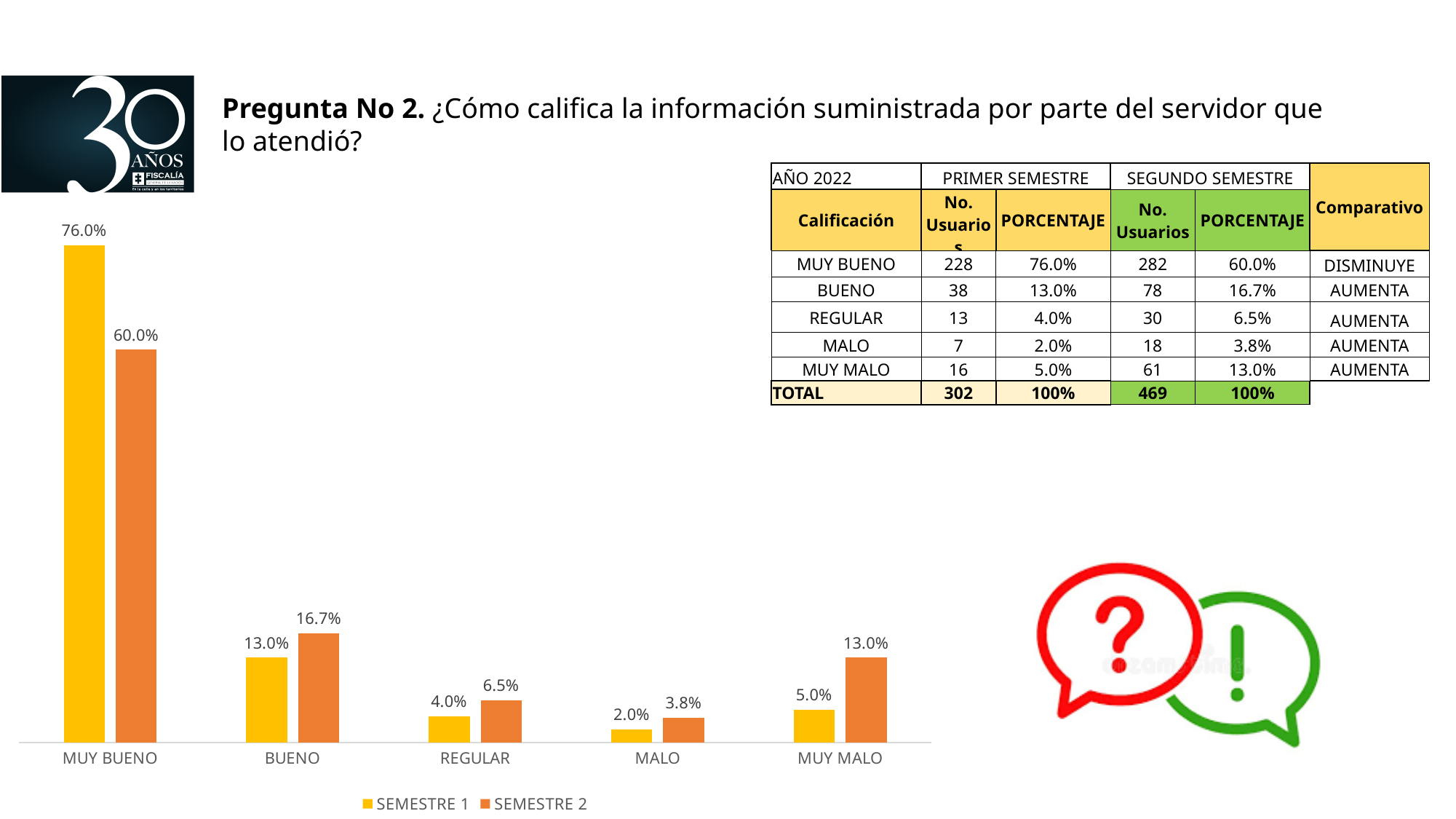
How many series does the chart legend list? 2 What is the value for MUY BUENO in the SEMESTRE 1 series? 76.0% What is the difference between the SEMESTRE 2 and SEMESTRE 1 values for BUENO? 3.7% Which category has the lowest value in the SEMESTRE 1 series? MALO What is the difference between the SEMESTRE 1 and SEMESTRE 2 values for MUY BUENO? 16.0% What kind of chart is shown on the slide? Bar chart Which is larger for MUY MALO: the SEMESTRE 1 value or the SEMESTRE 2 value? SEMESTRE 2 How many categories are shown on the x axis of the chart? 5 Which category has the highest value in the SEMESTRE 2 series? MUY BUENO What is the value for REGULAR in the SEMESTRE 2 series? 6.5% What is the value for MUY MALO in the SEMESTRE 2 series? 13.0% What colour are the SEMESTRE 2 bars in the chart? Orange